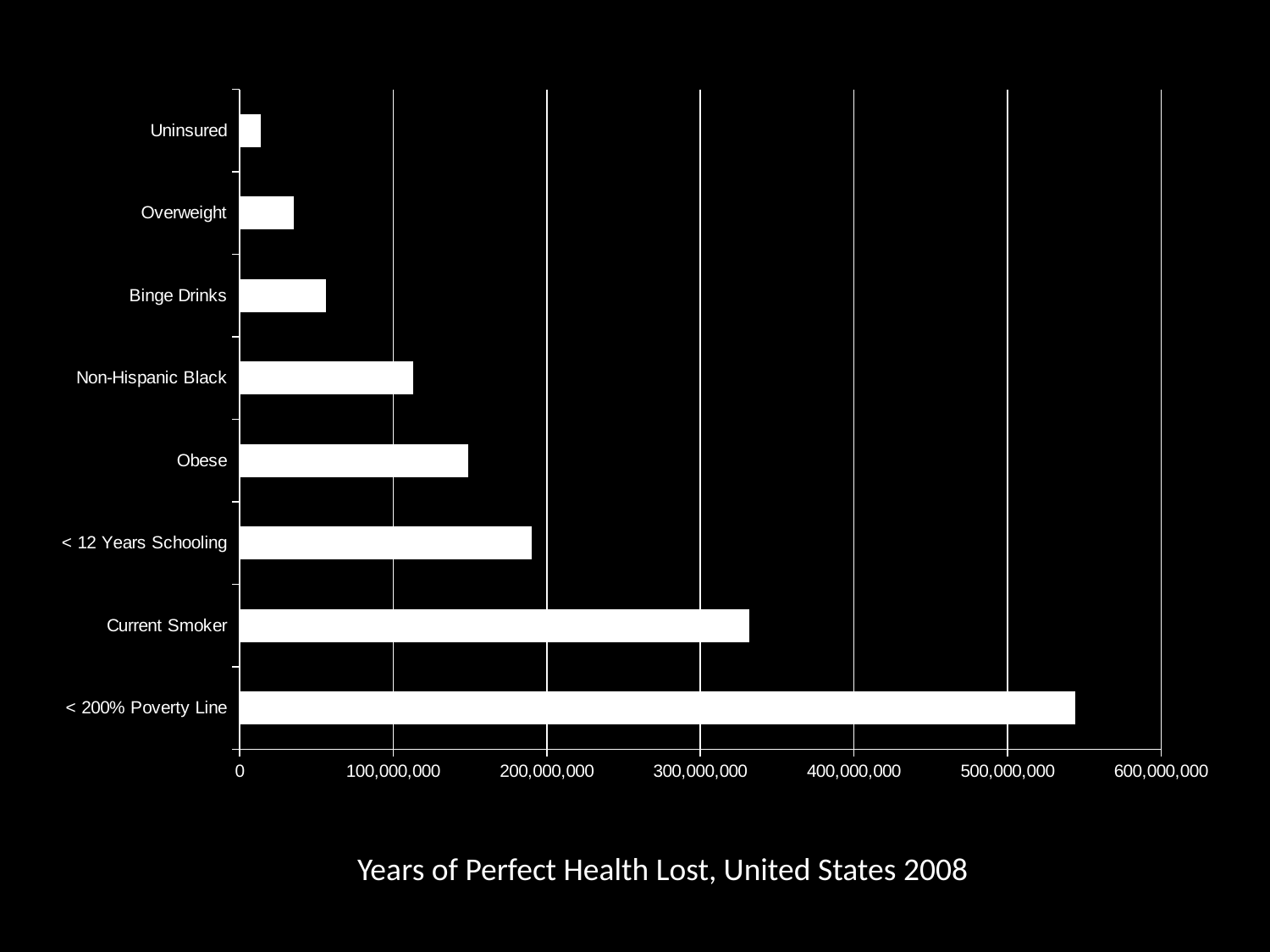
Is the value for Overweight greater or less than 100,000,000? less What kind of chart is shown on the slide? bar chart Is the value for Current Smoker greater or less than 300,000,000? greater Which category has the lowest value in the chart? Uninsured Which is larger, the value for Non-Hispanic Black or the value for Binge Drinks? Non-Hispanic Black What is the title shown beneath the chart? Years of Perfect Health Lost, United States 2008 Which is larger, the value for Current Smoker or the value for Obese? Current Smoker Is the value for Obese greater or less than 100,000,000? greater How many categories are plotted in the chart? 8 Which category has the highest value in the chart? < 200% Poverty Line